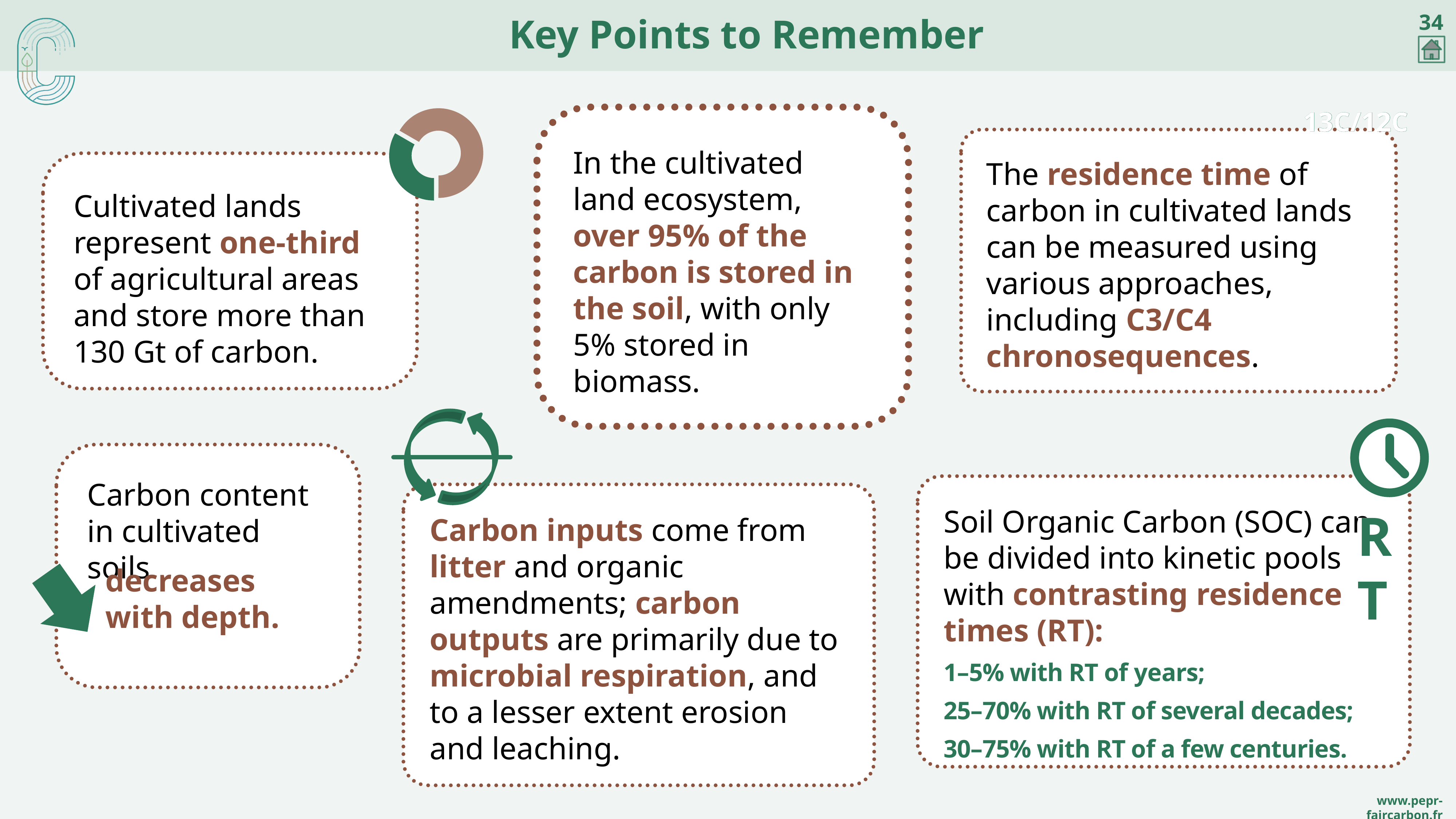
In the small doughnut chart next to the 'Cultivated lands' box, which slice is larger, the green one or the brown one? the brown one In the small doughnut chart next to the 'Cultivated lands' box, which slice is the smallest? the green slice What two colours are used for the slices of the small doughnut chart next to the 'Cultivated lands' box? green and brown Does the small doughnut chart next to the 'Cultivated lands' box show a legend? No How many slices does the small doughnut chart next to the 'Cultivated lands' box have? 2 What kind of chart is the small graphic at the top of the left-hand text box about cultivated lands? doughnut (pie) chart